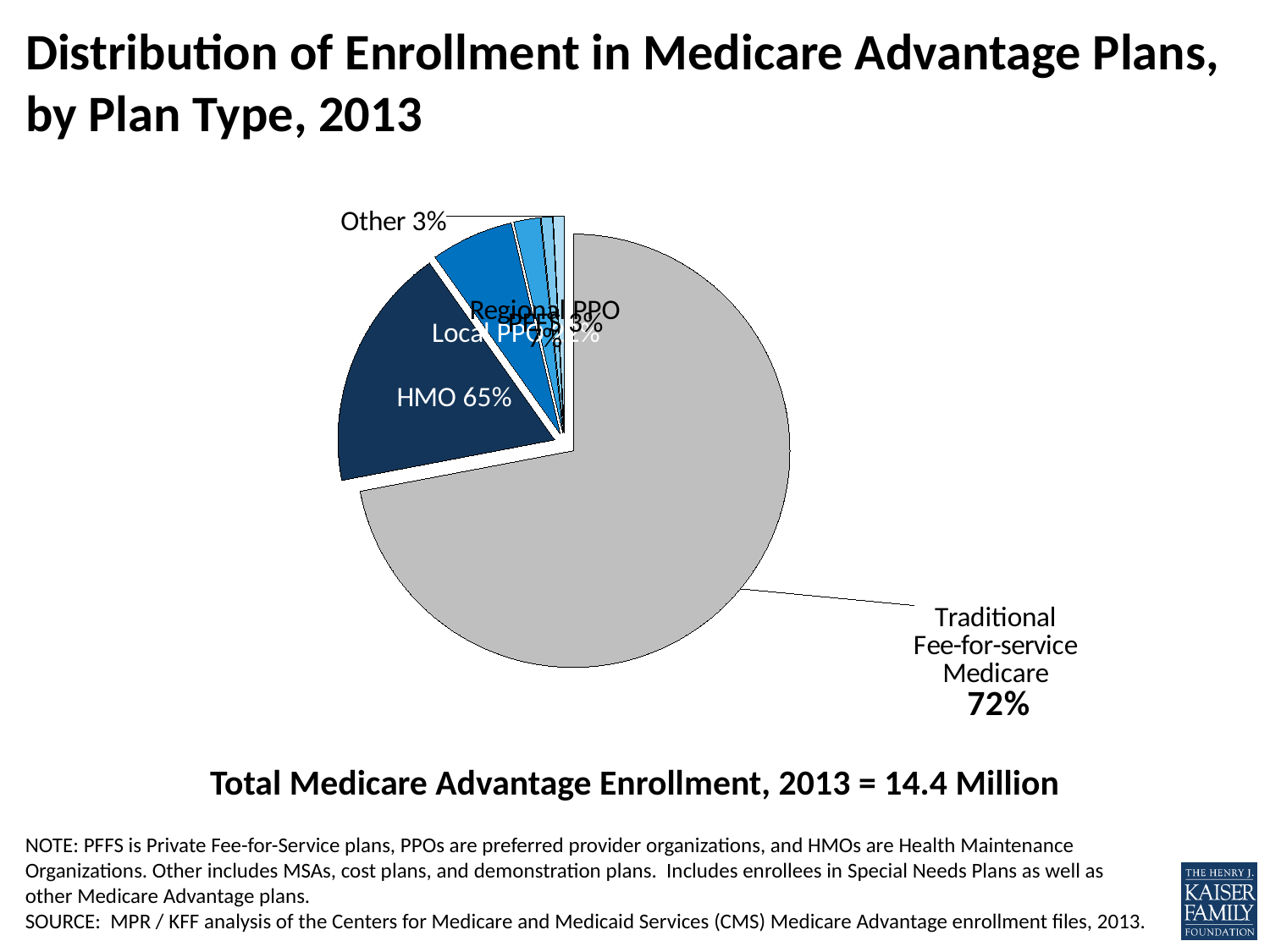
What is the difference in percentage points between the HMO label (65%) and the Other label (3%)? 62 percentage points What percentage is shown for HMO? 65% What share of the pie is labeled for Traditional Fee-for-service Medicare? 72% Which is larger, the Traditional Fee-for-service Medicare slice or the HMO slice? Traditional Fee-for-service Medicare According to the text below the chart, what was total Medicare Advantage enrollment in 2013? 14.4 Million Which category has the largest slice of the pie? Traditional Fee-for-service Medicare What kind of chart is shown on the slide? Pie chart What colour is the Traditional Fee-for-service Medicare slice? Gray What percentage is shown for Regional PPO? 3% What is the difference in percentage points between the Traditional Fee-for-service Medicare label (72%) and the HMO label (65%)? 7 percentage points Which is larger, the HMO slice or the Other slice? HMO What percentage is shown for the Other category? 3%